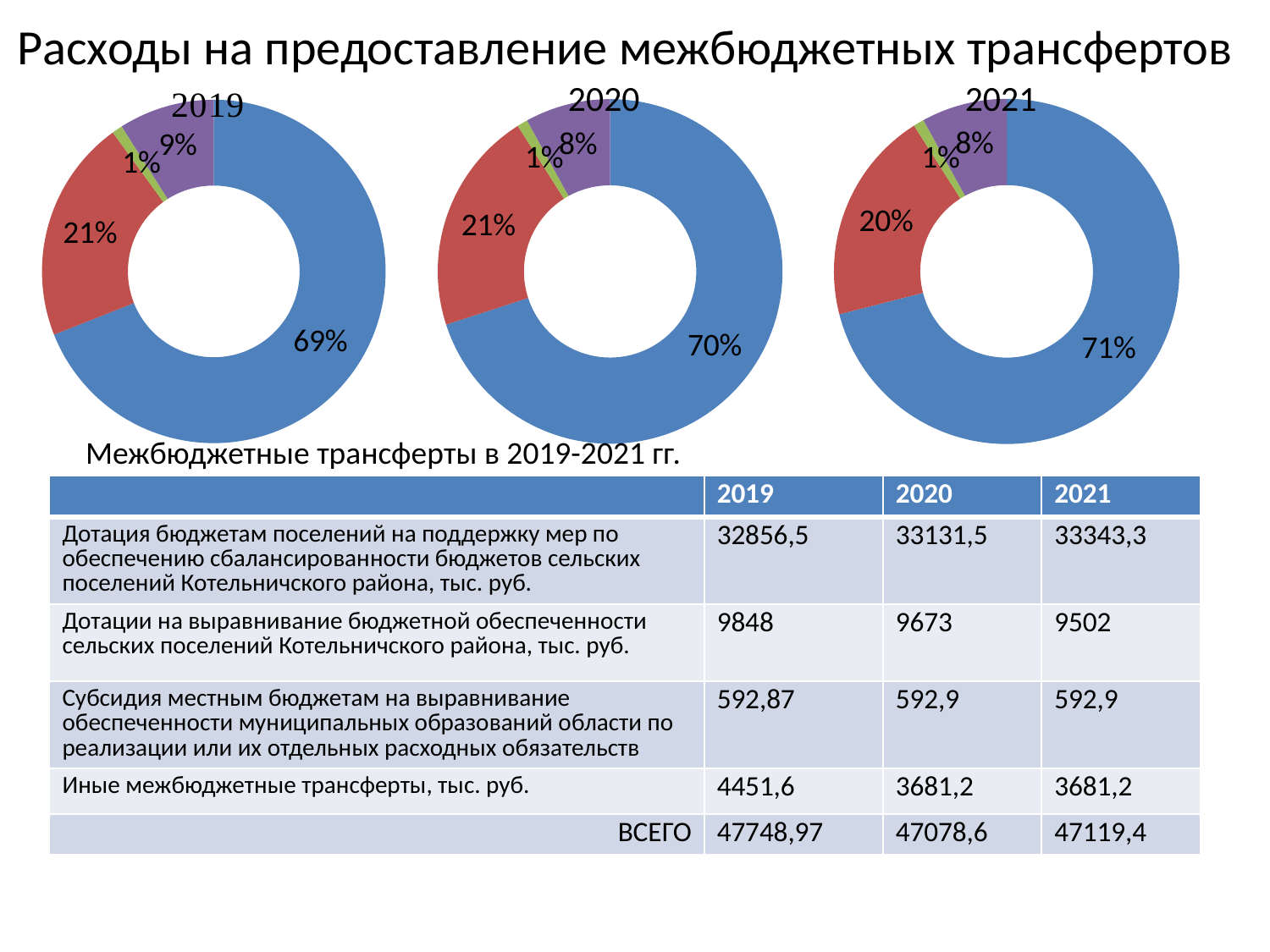
How many slices does each doughnut chart have? 4 Does the share of the blue slice rise or fall from the 2019 chart to the 2021 chart? rise Which chart has the largest share for the blue slice: 2019, 2020 or 2021? 2021 In the 2020 chart, what share does the largest (blue) slice have? 70% In the 2020 chart, what share does the smallest (green) slice have? 1% In the 2019 chart, what share does the purple slice have? 9% What is the difference between the blue slice share in the 2021 chart and in the 2019 chart? 2% How many charts are on the slide? 3 In the 2021 chart, what share does the largest (blue) slice have? 71% What type of charts are shown on the slide? doughnut (pie) charts